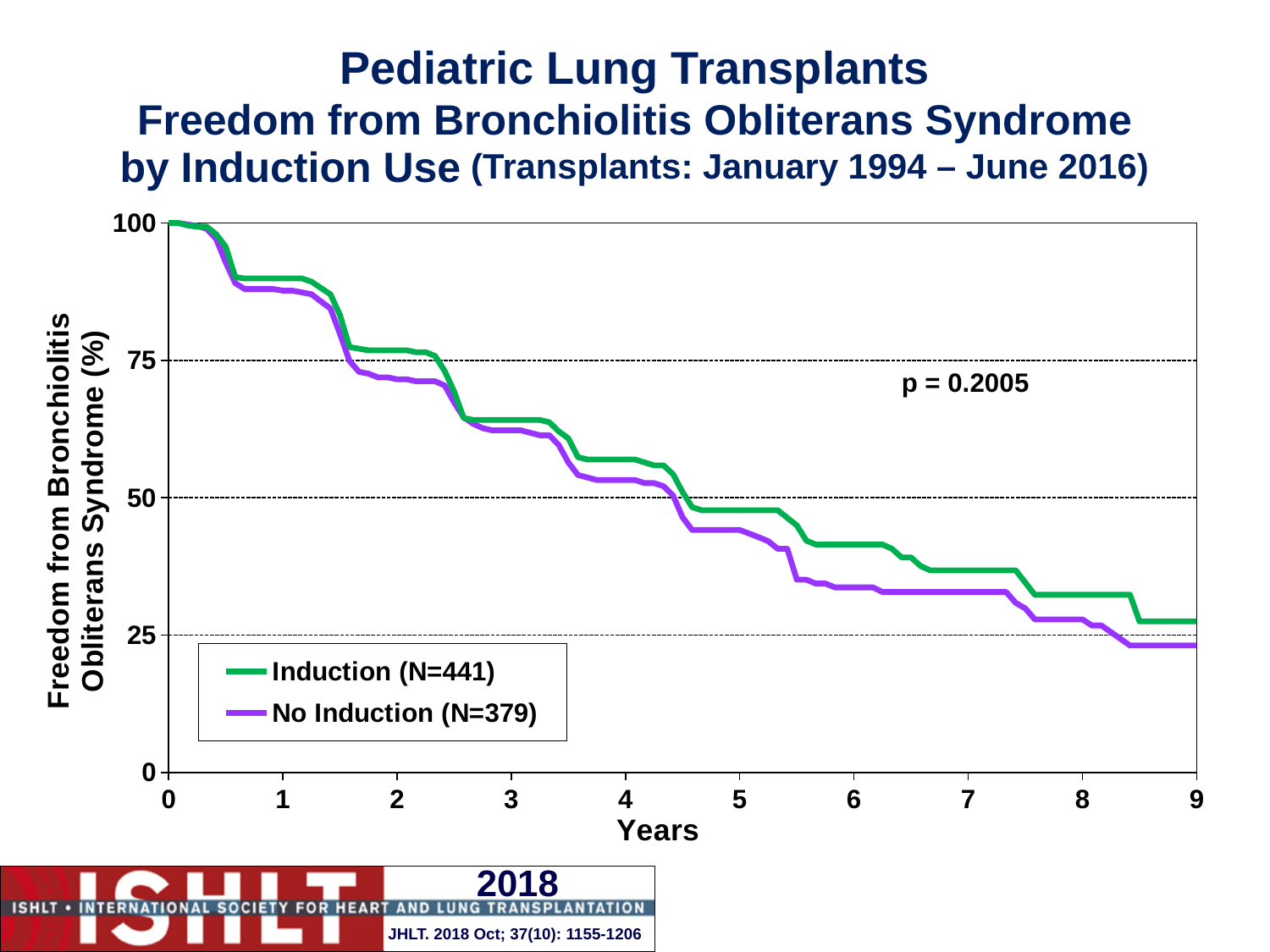
Is the value for the No Induction series at 9 years greater or less than 25? less What is the N for the No Induction series shown in the legend? 379 Do the values for the Induction series rise or fall as years increase? fall What p-value is printed on the chart? p = 0.2005 How many series does the legend list? 2 Is the value for the Induction series at 7 years greater or less than 50? less What kind of chart is shown on the slide? line chart Is the value for the No Induction series at 5 years greater or less than 50? less At 6 years, which series has the higher value, Induction or No Induction? Induction What is the value for the Induction series at 0 years? 100